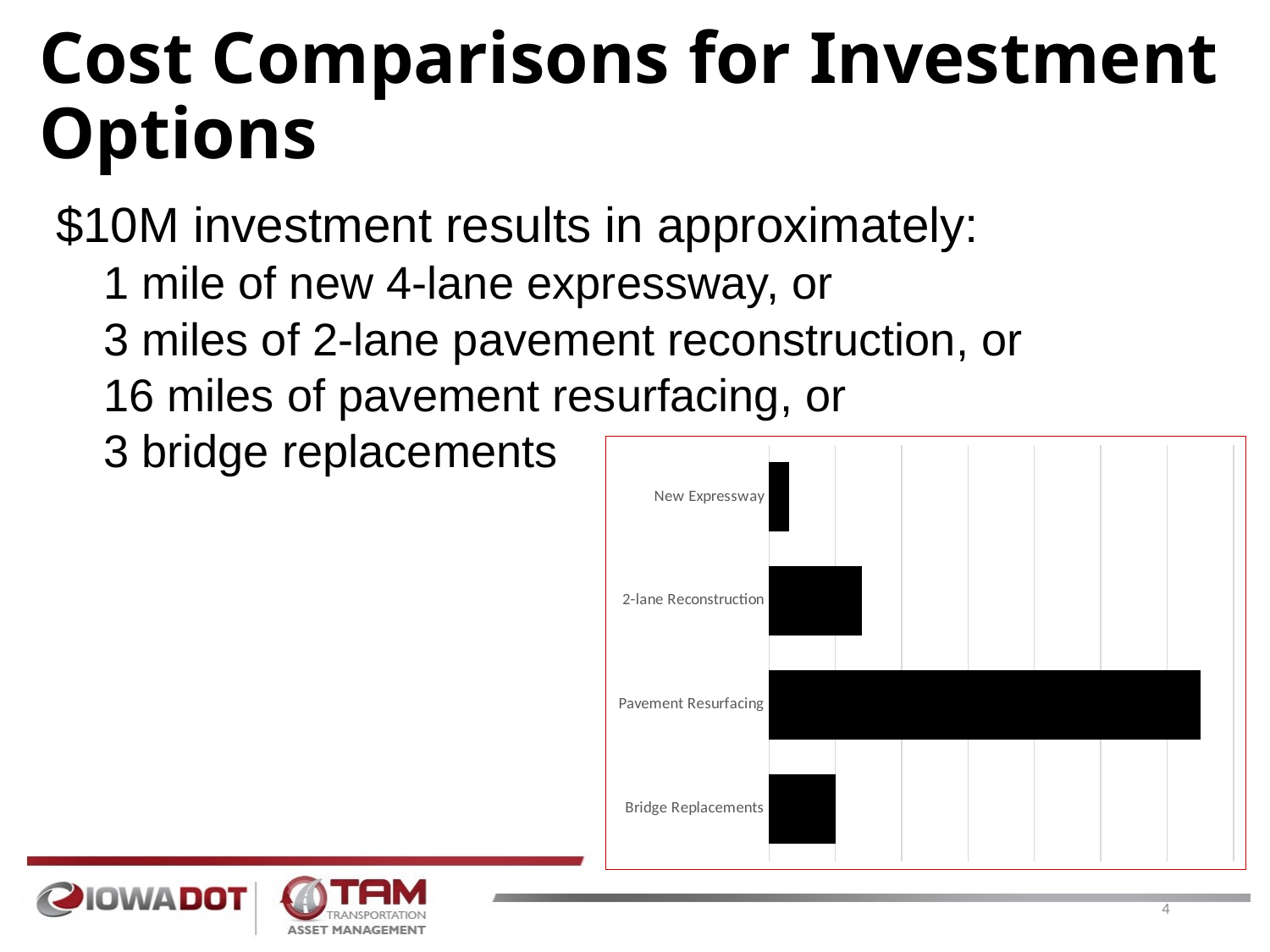
Which bar is longer, Bridge Replacements or Pavement Resurfacing? Pavement Resurfacing Which bar is longer, New Expressway or Pavement Resurfacing? Pavement Resurfacing Which category is listed at the top of the bar chart? New Expressway Are the bars in the chart horizontal or vertical? horizontal What colour are the bars in the chart? black What kind of chart is shown on the slide? bar chart Which category has the shortest bar in the chart? New Expressway How many categories does the bar chart show? 4 Which bar is longer, New Expressway or 2-lane Reconstruction? 2-lane Reconstruction Which category has the longest bar in the chart? Pavement Resurfacing